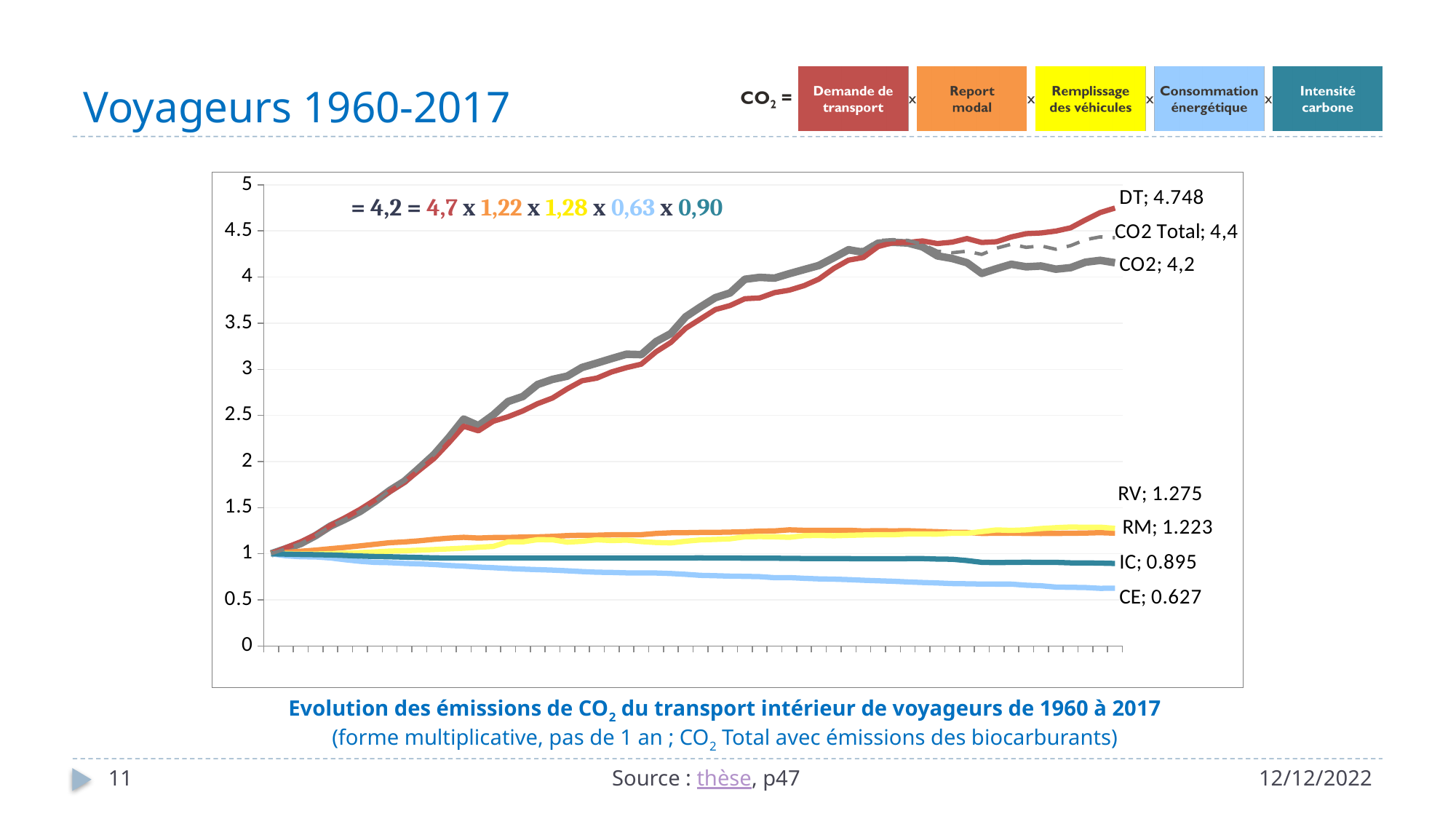
What is the final value labelled for the CO2 Total series? 4,4 What is the final value labelled for the CE series? 0.627 What is the final value labelled for the DT series? 4.748 What is the difference between the labelled end values of RV and RM? 0.052 Does the CE series rise or fall from 1960 to 2017? fall What is the final value labelled for the IC series? 0.895 Which series has the highest labelled end value? DT Which has the larger labelled end value, IC or CE? IC How many series are labelled at the right end of the chart? 7 What kind of chart is shown on the slide? line chart What is the final value labelled for the RV series? 1.275 Which series has the lowest labelled end value? CE